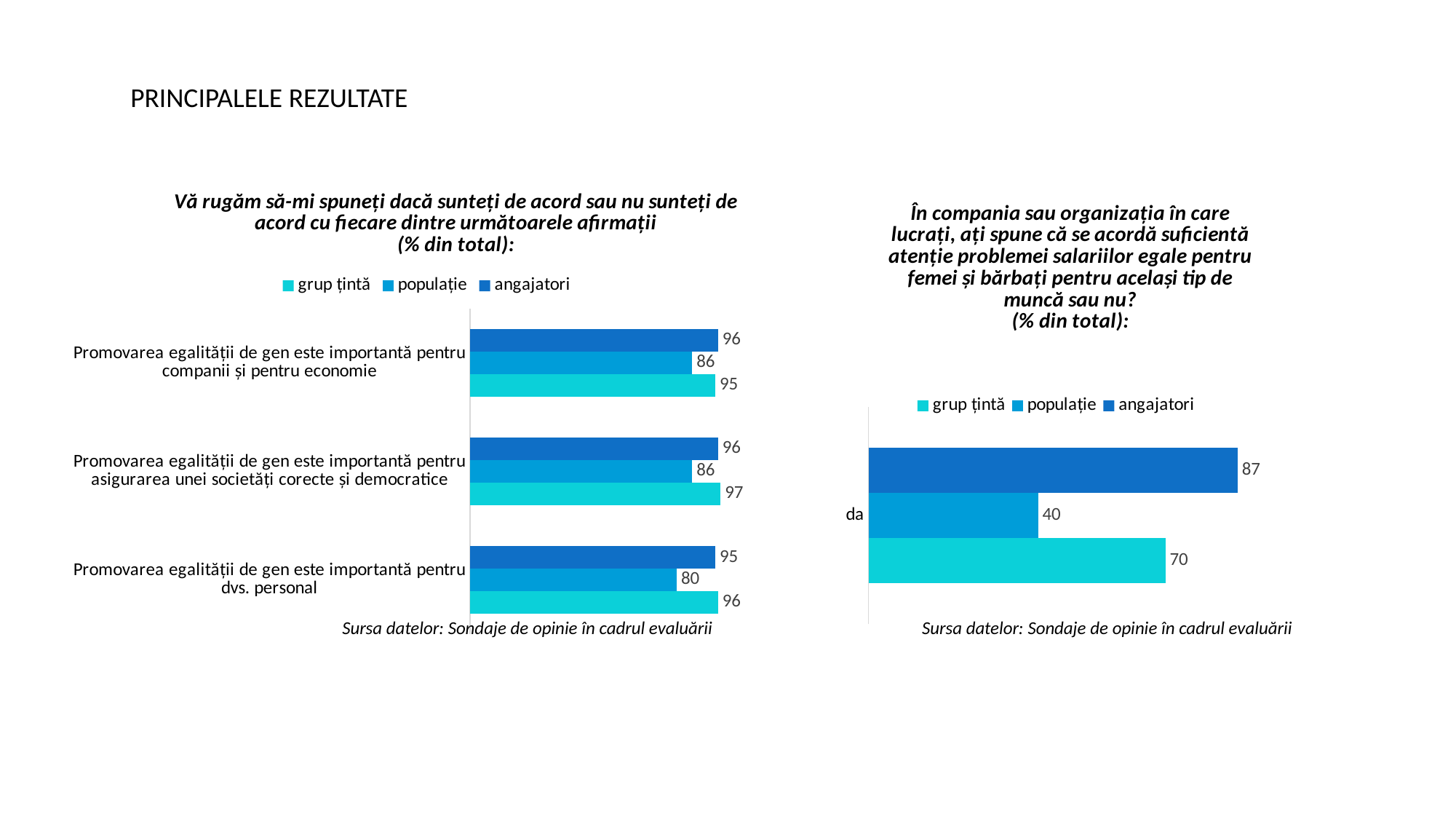
In the left chart, what is the difference between the 'angajatori' and 'populație' values for 'Promovarea egalității de gen este importantă pentru dvs. personal'? 15 In the right chart, what is the value for 'angajatori'? 87 In the right chart, what is the value for 'populație'? 40 In the right chart, which series has the lowest value? populație What kind of chart is the right chart? bar chart In the left chart, what is the value for 'grup țintă' for 'Promovarea egalității de gen este importantă pentru asigurarea unei societăți corecte și democratice'? 97 In the left chart, what is the value for 'populație' for 'Promovarea egalității de gen este importantă pentru dvs. personal'? 80 How many series does the legend of the left chart list? 3 In the left chart, which is larger for 'Promovarea egalității de gen este importantă pentru companii și pentru economie': the 'angajatori' value or the 'populație' value? angajatori In the right chart, what is the difference between the 'angajatori' value and the 'grup țintă' value? 17 In the right chart, which series has the highest value? angajatori In the left chart, what is the value for 'angajatori' for 'Promovarea egalității de gen este importantă pentru companii și pentru economie'? 96